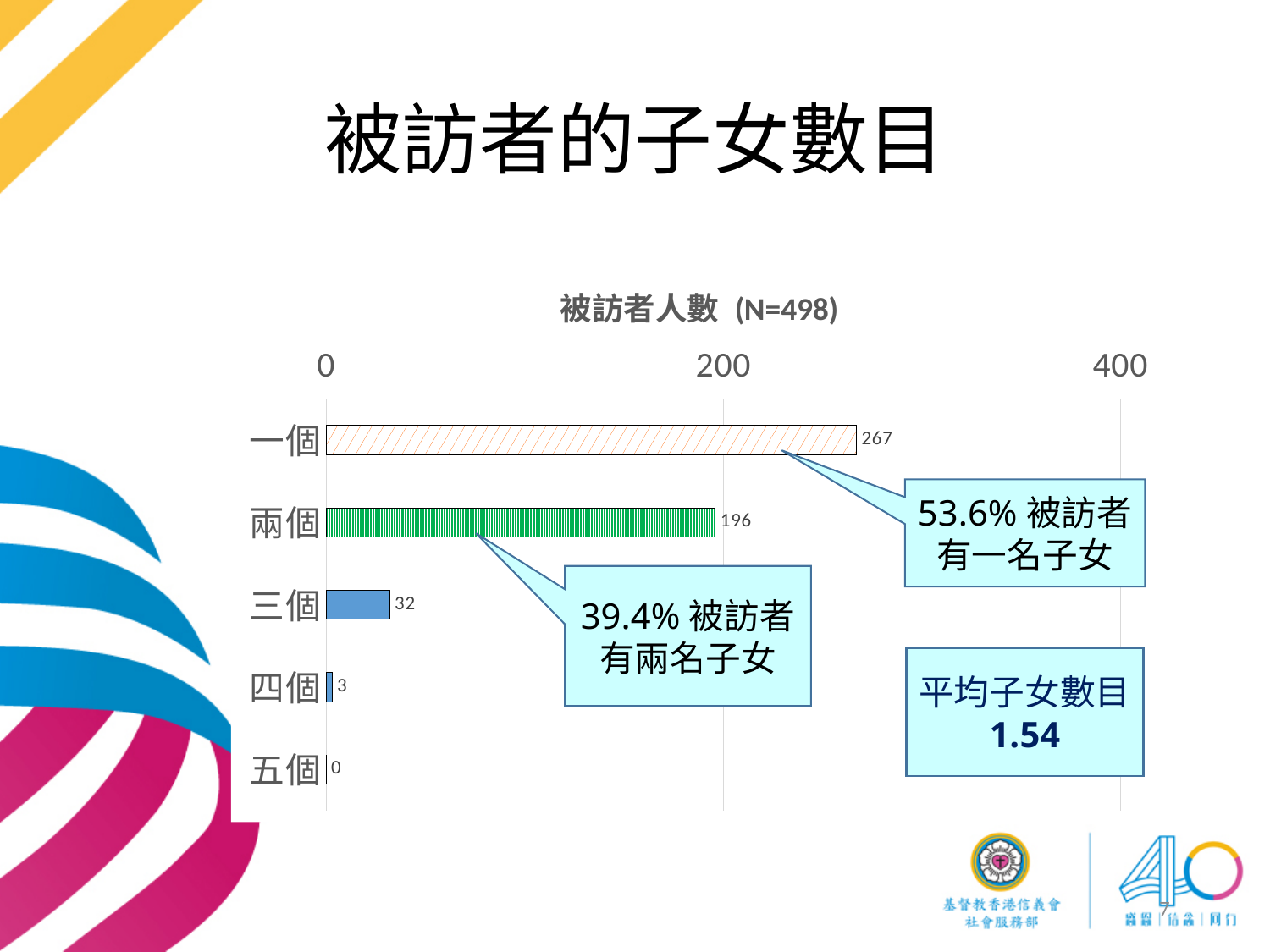
How many categories are shown on the chart? 5 What is the value for 兩個 (two children)? 196 What is the value for 一個 (one child)? 267 What is the value for 四個 (four children)? 3 Which category has the lowest value? 五個 What is the value for 三個 (three children)? 32 Is the value for 一個 greater or less than 200? greater Which is larger, the value for 三個 or the value for 四個? 三個 Which category has the highest value? 一個 What is the difference between the values for 一個 and 兩個? 71 What is the value for 五個 (five children)? 0 What kind of chart is shown on the slide? bar chart